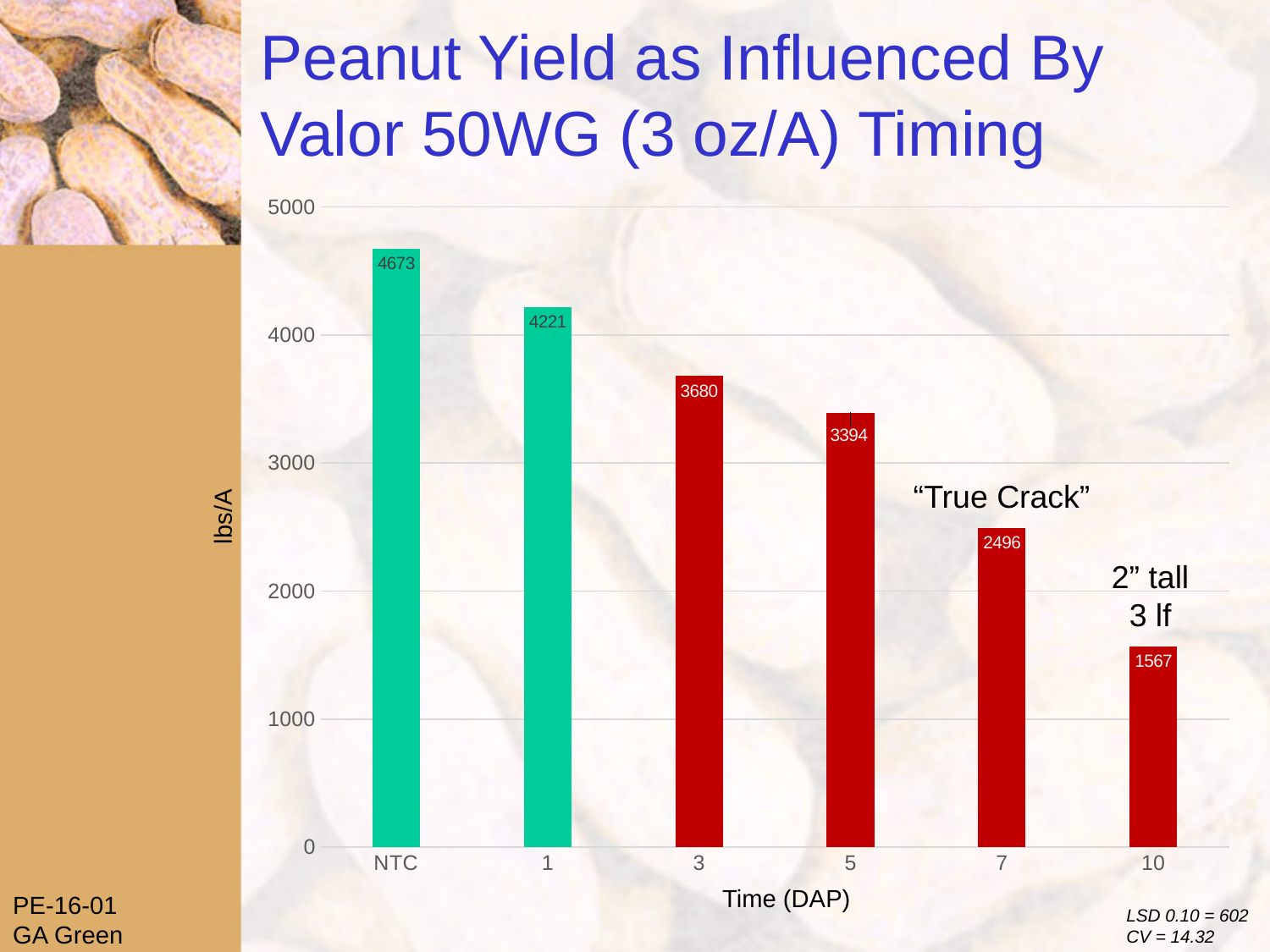
How many timing categories are shown on the x axis? 6 Which has a higher yield, the 5 DAP timing or the 7 DAP timing? 5 DAP What is the peanut yield (lbs/A) for the NTC treatment? 4673 Is the yield for the 7 DAP timing greater or less than 3000? less Which timing category has the highest yield? NTC What kind of chart is shown on the slide? bar chart Do the yield values rise or fall as the application timing (DAP) increases along the x axis? fall What is the yield value for the 5 DAP timing? 3394 What is the yield value for the 10 DAP timing? 1567 What is the difference in yield between the 3 DAP and 7 DAP timings? 1184 Which timing category has the lowest yield? 10 What is the difference in yield between the NTC and the 1 DAP timing? 452